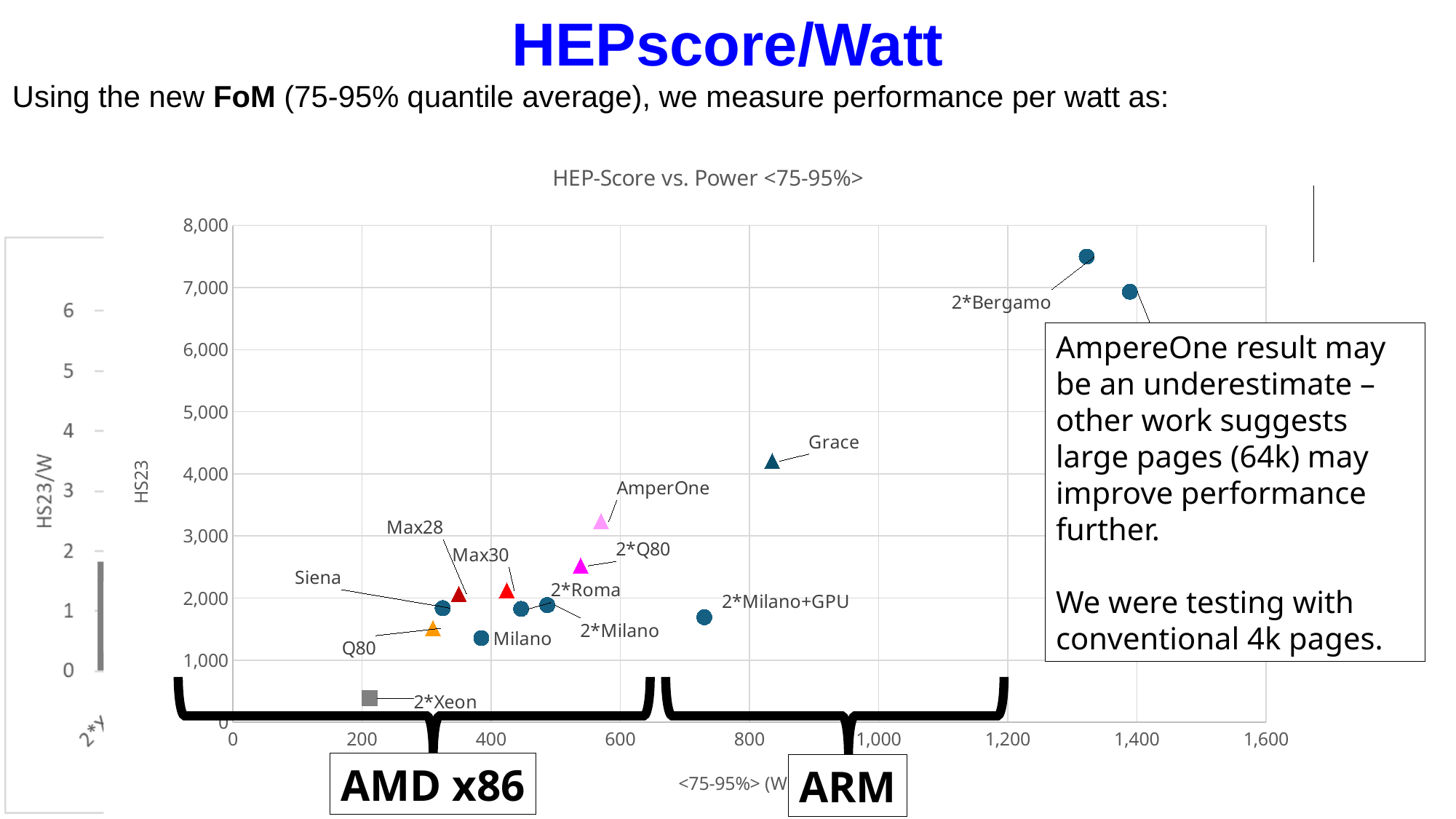
Is the HS23 value for 2*Bergamo greater or less than 7,000? greater Which labelled point has the lowest HS23 value in the HEP-Score vs. Power chart? 2*Xeon Is the HS23 value for Grace greater or less than 3,000? greater What is the title of the scatter chart? HEP-Score vs. Power <75-95%> What is the label of the vertical axis of the HEP-Score vs. Power chart? HS23 What kind of chart is the HEP-Score vs. Power chart? scatter chart Which labelled point has the highest HS23 value in the HEP-Score vs. Power chart? 2*Bergamo Is the power value (x axis) for 2*Milano+GPU greater or less than 600? greater Which has the higher HS23 value, 2*Q80 or Q80? 2*Q80 Which has the higher HS23 value, Grace or AmperOne? Grace